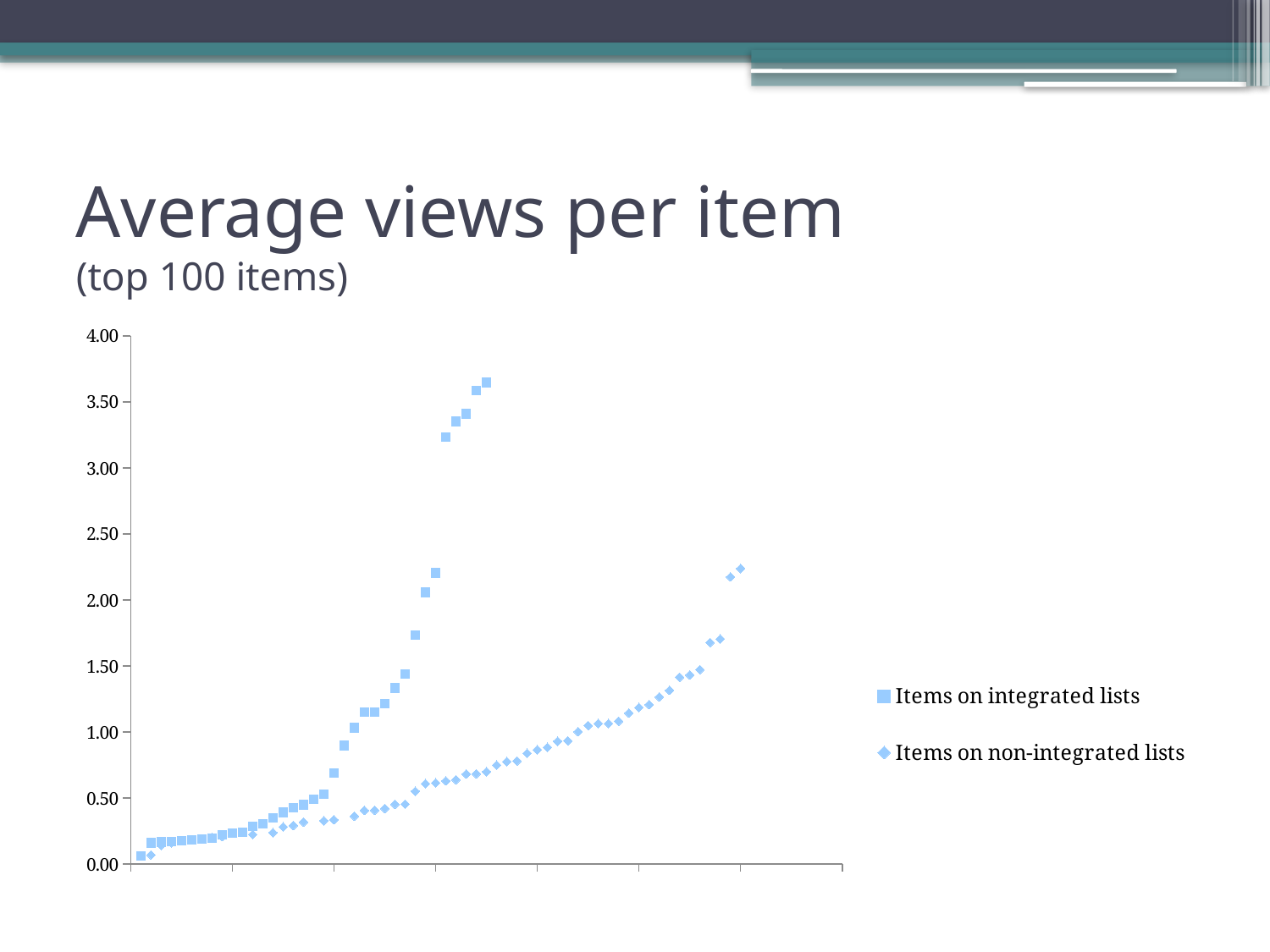
Do the values for Items on integrated lists rise or fall from left to right along the x axis? rise What is the title of the chart on the slide? Average views per item (top 100 items) What kind of chart is shown on the slide? scatter chart How many series does the legend list? 2 Is the highest value for Items on non-integrated lists greater or less than 2.50? less Is the lowest value for Items on integrated lists greater or less than 0.50? less What are the two series named in the legend? Items on integrated lists; Items on non-integrated lists Is the highest value for Items on integrated lists greater or less than 3.50? greater Which series has the higher maximum value on the chart? Items on integrated lists Do the values for Items on non-integrated lists rise or fall from left to right along the x axis? rise Which series reaches the higher maximum value, Items on integrated lists or Items on non-integrated lists? Items on integrated lists